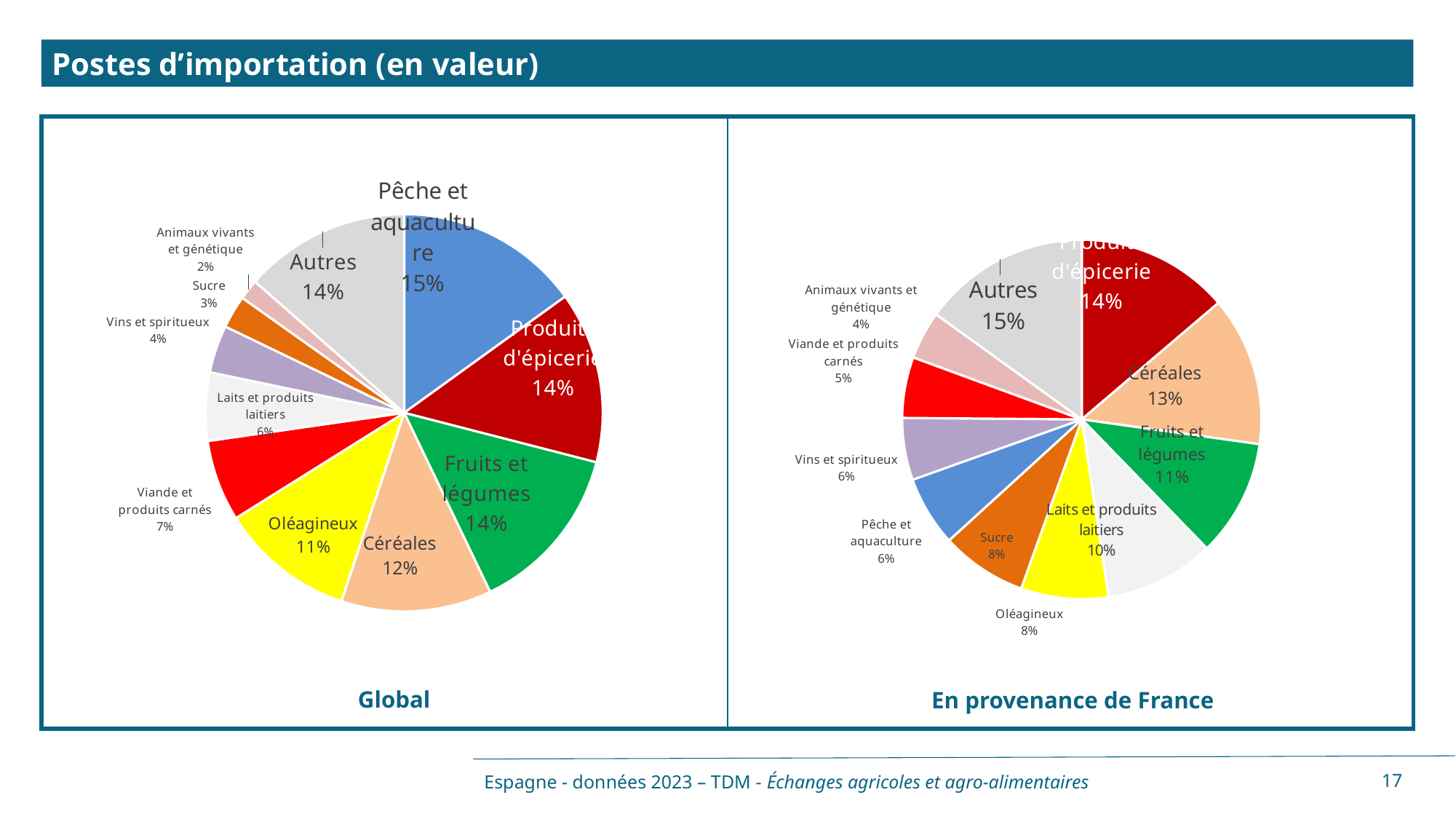
In the En provenance de France pie chart, what share do Laits et produits laitiers represent? 10% In the En provenance de France pie chart, what is the share for Sucre? 8% In the Global pie chart, what share do Pêche et aquaculture imports represent? 15% In the Global pie chart, which category has the smallest share? Animaux vivants et génétique In the Global pie chart, what is the difference between the shares of Oléagineux and Viande et produits carnés? 4 percentage points In the En provenance de France pie chart, which is larger: the share of Céréales or the share of Fruits et légumes? Céréales In the Global pie chart, what is the share for Céréales? 12% How many categories are shown in the Global pie chart? 11 In the Global pie chart, which category has the largest share? Pêche et aquaculture In the En provenance de France pie chart, which category has the smallest share? Animaux vivants et génétique What is the title of the chart on the right side of the slide? En provenance de France What type of chart is used for En provenance de France? Pie chart